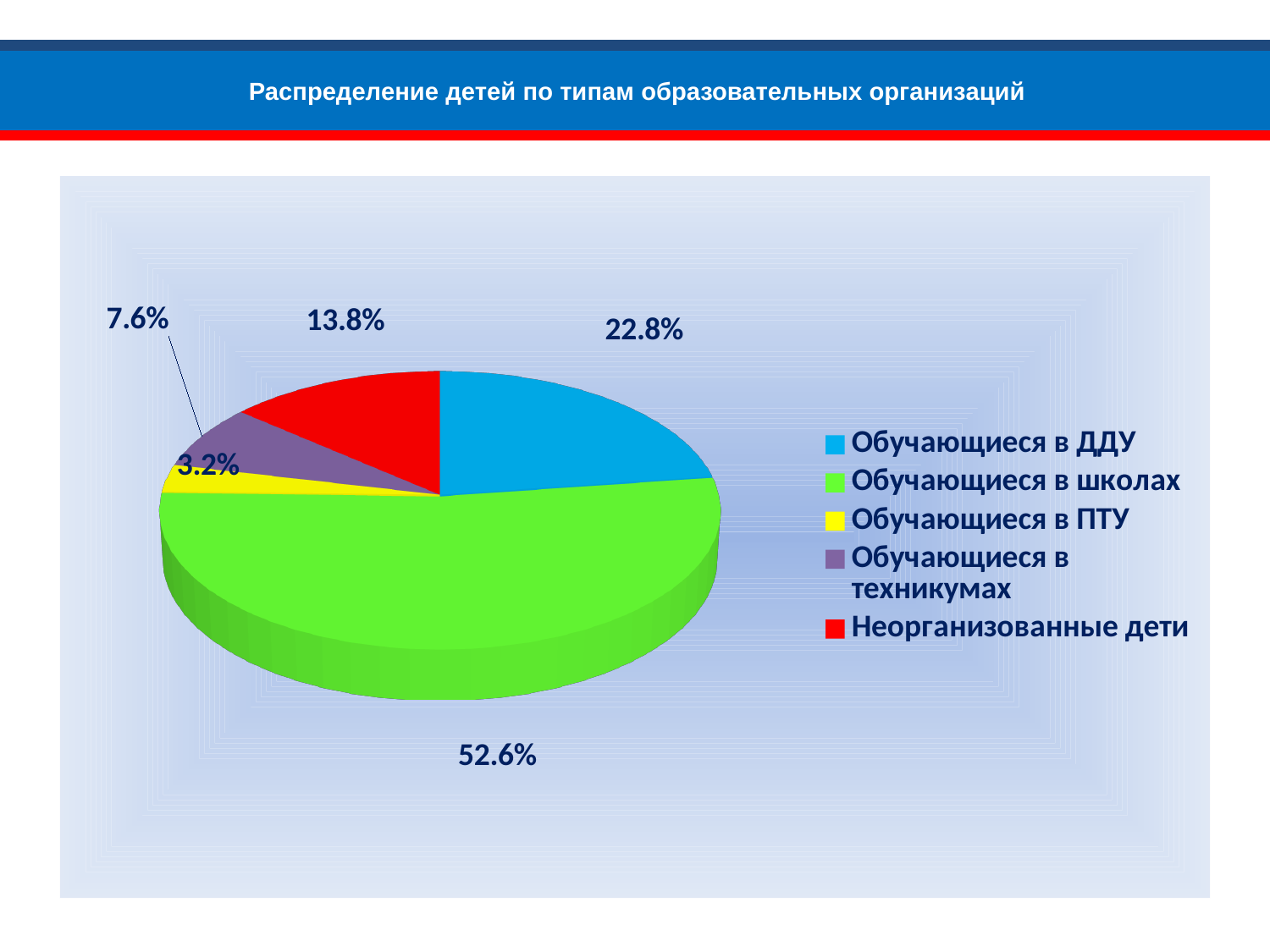
Which is larger: the share of 'Обучающиеся в техникумах' or 'Обучающиеся в ПТУ'? Обучающиеся в техникумах What is the title of the chart? Распределение детей по типам образовательных организаций What share of the pie is 'Обучающиеся в ПТУ'? 3.2% What kind of chart is shown on the slide? Pie chart What share of the pie is 'Обучающиеся в школах'? 52.6% Which category has the smallest share of the pie? Обучающиеся в ПТУ How many categories does the legend list? 5 What share of the pie is 'Обучающиеся в ДДУ'? 22.8% What share of the pie is 'Неорганизованные дети'? 13.8% What share of the pie is 'Обучающиеся в техникумах'? 7.6% Which category has the largest share of the pie? Обучающиеся в школах What is the difference between the shares of 'Обучающиеся в ДДУ' and 'Неорганизованные дети'? 9.0%